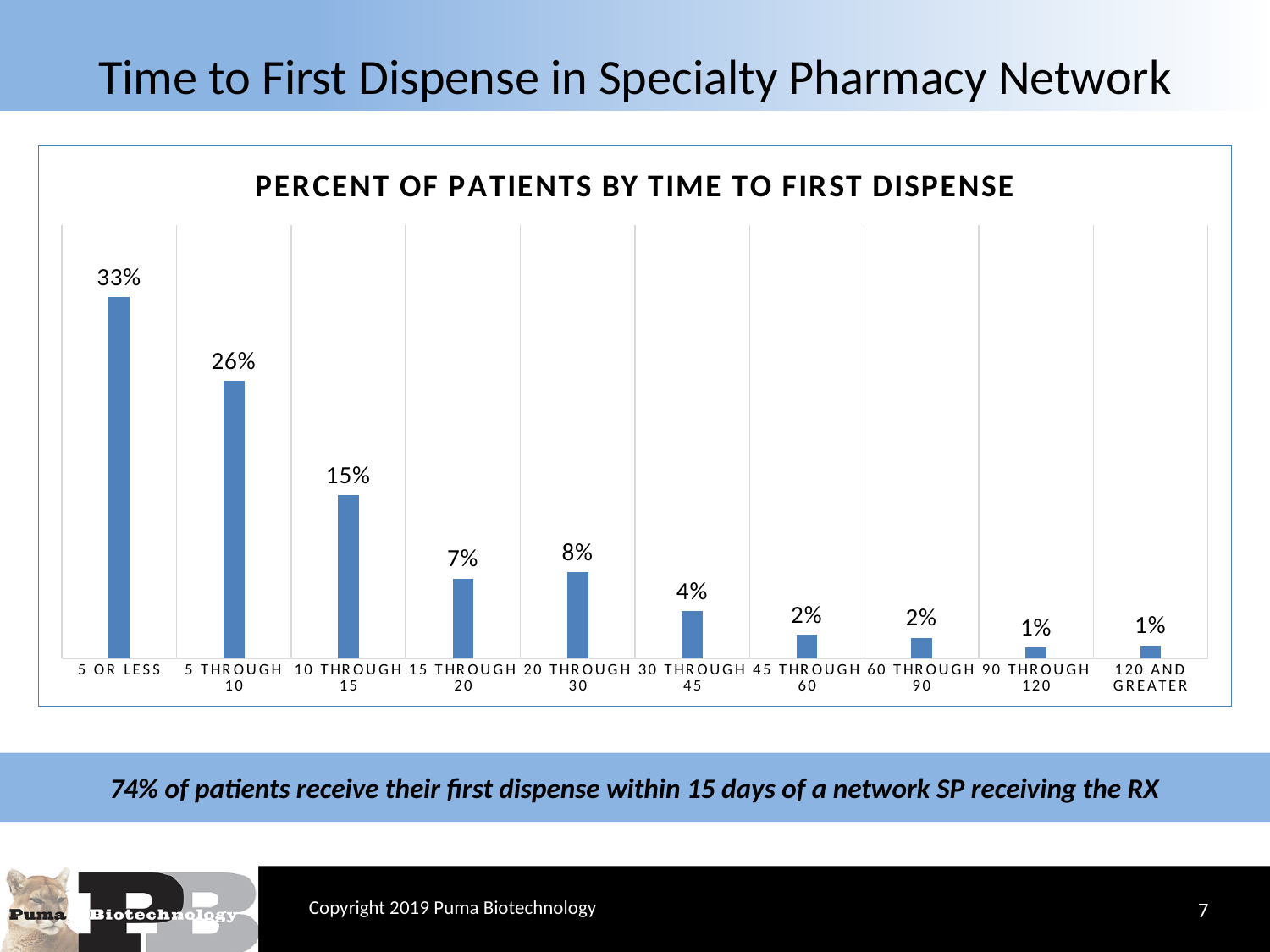
What percent of patients had a time to first dispense of 5 or less days? 33% Which category has the highest percent of patients? 5 or less What is the value for the 20 through 30 category? 8% What is the value for the 10 through 15 category? 15% How many categories are shown on the x axis? 10 What is the title of the chart? Percent of Patients by Time to First Dispense Do the values generally rise or fall from left to right along the x axis? Fall What kind of chart is shown on the slide? Bar chart What is the value for the 120 and greater category? 1% Which is larger, the value for 15 through 20 or the value for 20 through 30? 20 through 30 What is the difference between the 5 or less and 5 through 10 categories? 7% What is the difference between the 10 through 15 and 15 through 20 categories? 8%